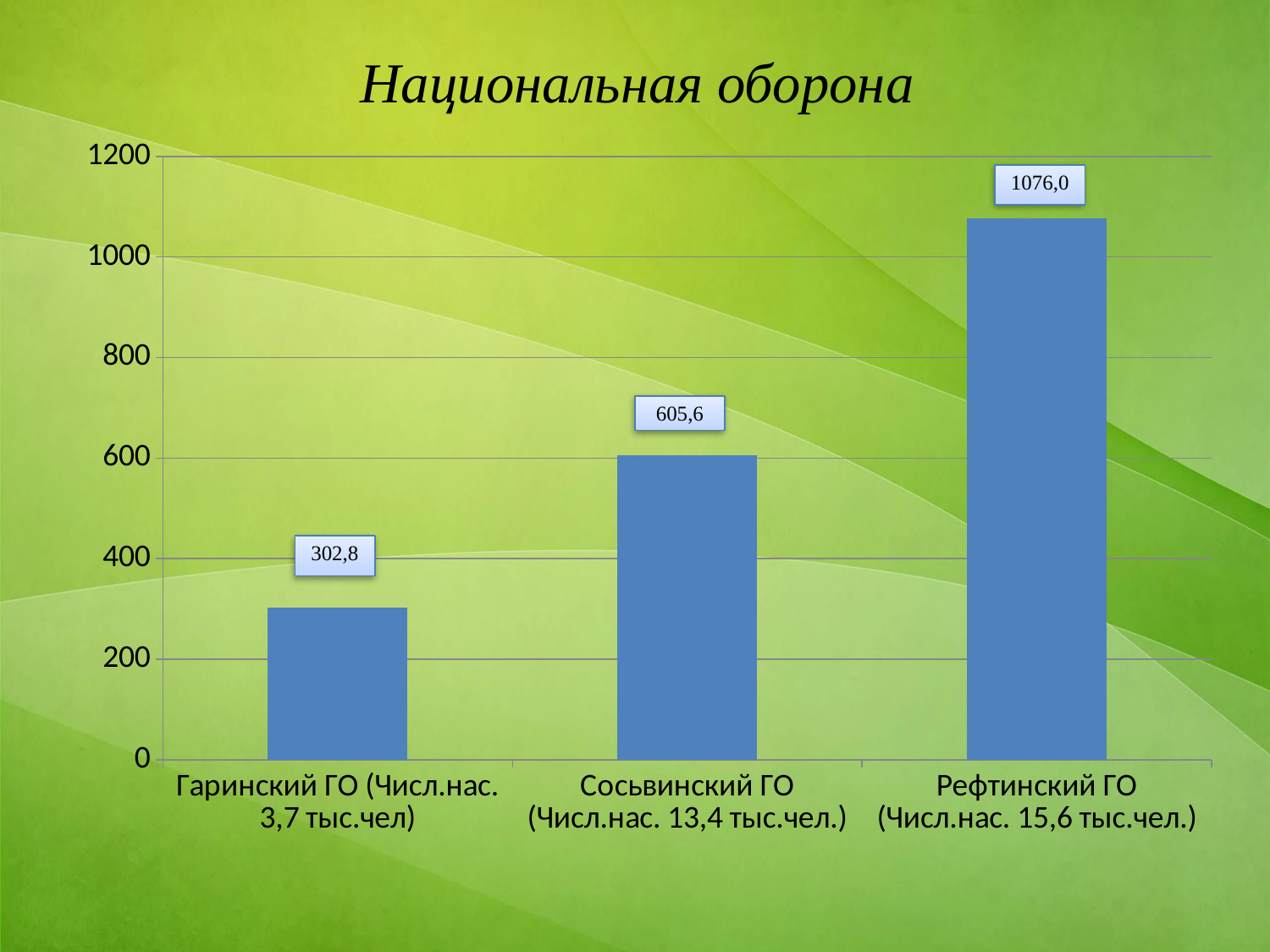
What kind of chart is shown on the slide? bar chart How many categories are shown in the chart? 3 Is the value for Рефтинский ГО greater or less than 1000? greater Which is larger, the value for Сосьвинский ГО or the value for Гаринский ГО? Сосьвинский ГО What is the value for Сосьвинский ГО? 605,6 What is the value for Гаринский ГО? 302,8 Which category has the highest value? Рефтинский ГО What is the difference between the values for Сосьвинский ГО and Гаринский ГО? 302,8 Which category has the lowest value? Гаринский ГО What is the value for Рефтинский ГО? 1076,0 What is the title of the chart? Национальная оборона What is the difference between the values for Рефтинский ГО and Гаринский ГО? 773,2